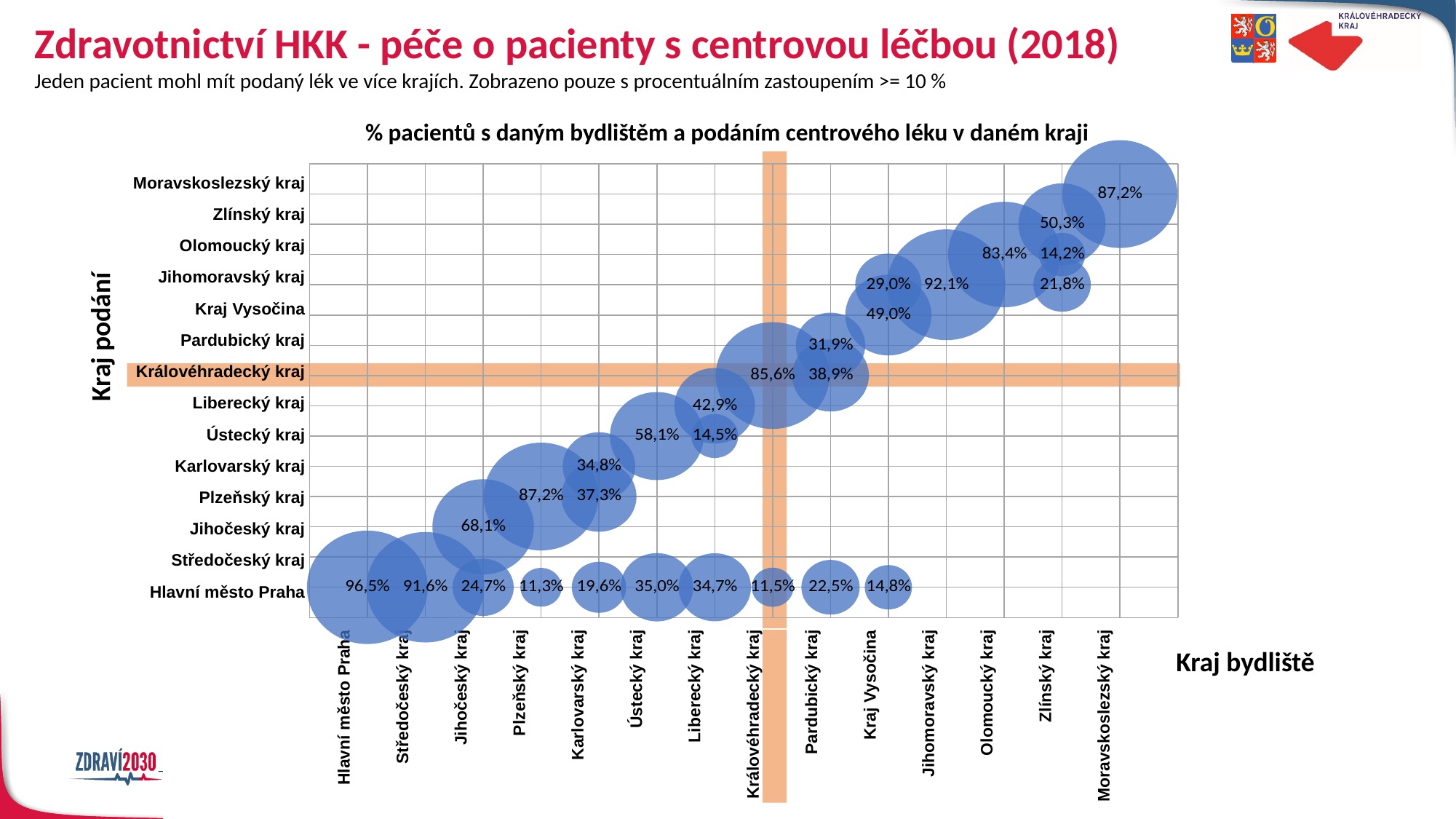
Which is larger: the percentage of Jihomoravský kraj residents treated in Jihomoravský kraj, or the percentage of Olomoucký kraj residents treated in Olomoucký kraj? Jihomoravský kraj residents treated in Jihomoravský kraj (92,1%) What type of chart is shown on the slide? bubble chart What is the difference between the percentage of Královéhradecký kraj residents and Pardubický kraj residents treated in Královéhradecký kraj? 46,7% What percentage of patients residing in Královéhradecký kraj received centre treatment in Královéhradecký kraj? 85,6% What percentage of patients residing in Středočeský kraj received centre treatment in Hlavní město Praha? 91,6% What is the lowest percentage value shown in the chart? 11,3% What is the highest percentage value shown in the chart? 96,5% How many bubbles are shown in the Hlavní město Praha row (Kraj podání)? 10 How many regions of residence (Kraj bydliště) are listed on the x axis? 14 What percentage of patients residing in Zlínský kraj received centre treatment in Olomoucký kraj? 14,2% What percentage of patients residing in Pardubický kraj received centre treatment in Královéhradecký kraj? 38,9% What is the title of the chart? % pacientů s daným bydlištěm a podáním centrového léku v daném kraji